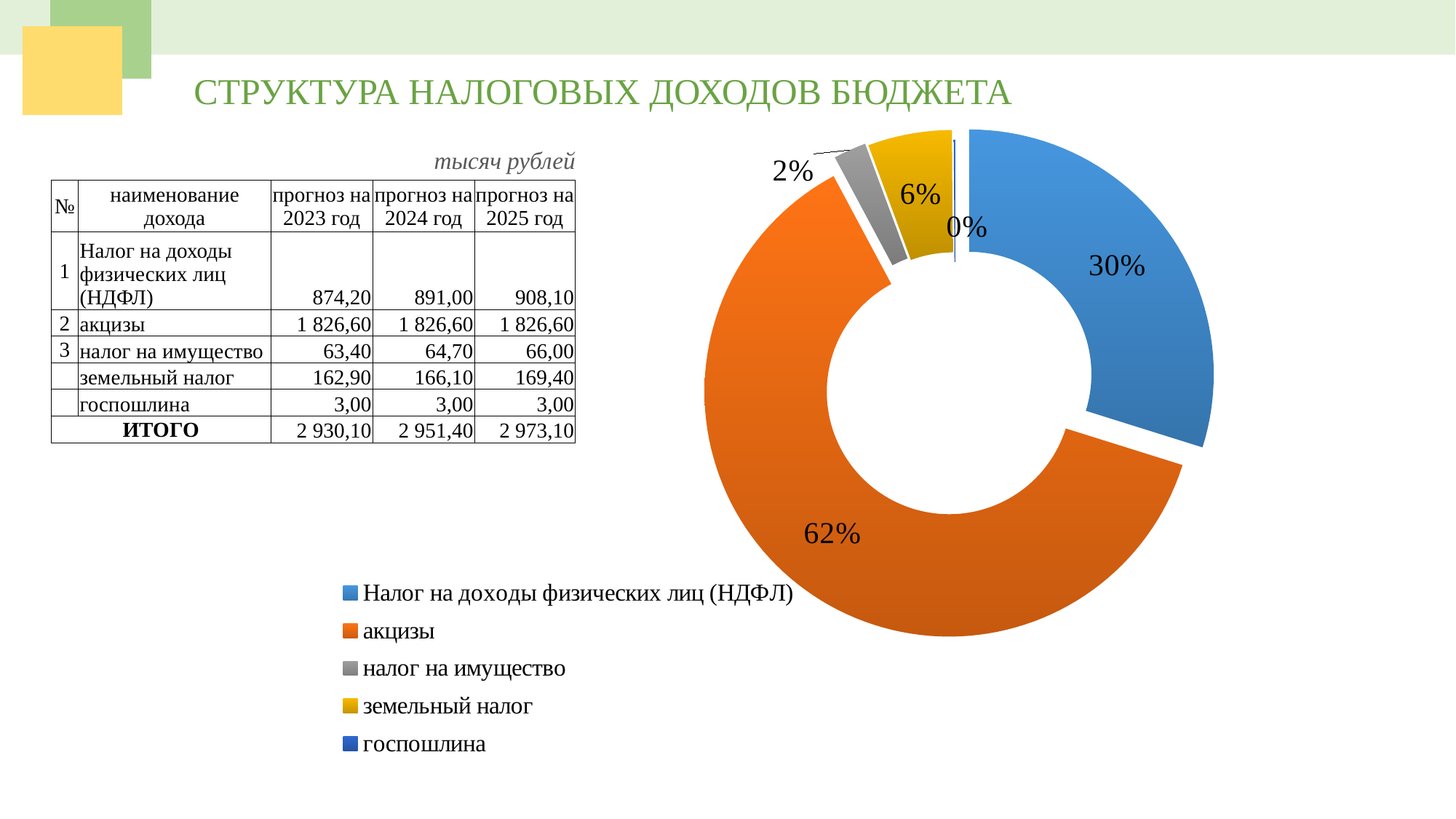
What share of the doughnut chart does госпошлина account for? 0% Which category has the smallest share in the doughnut chart? госпошлина What share of the doughnut chart does Налог на доходы физических лиц (НДФЛ) account for? 30% What share of the doughnut chart does земельный налог account for? 6% What is the difference in percentage points between the shares of акцизы and Налог на доходы физических лиц (НДФЛ) in the doughnut chart? 32 What kind of chart is shown on the slide? doughnut chart Which has a larger share in the doughnut chart, земельный налог or налог на имущество? земельный налог What colour is the акцизы segment in the doughnut chart? orange How many categories does the legend of the doughnut chart list? 5 Which category has the largest share in the doughnut chart? акцизы What share of the doughnut chart does акцизы account for? 62% What share of the doughnut chart does налог на имущество account for? 2%